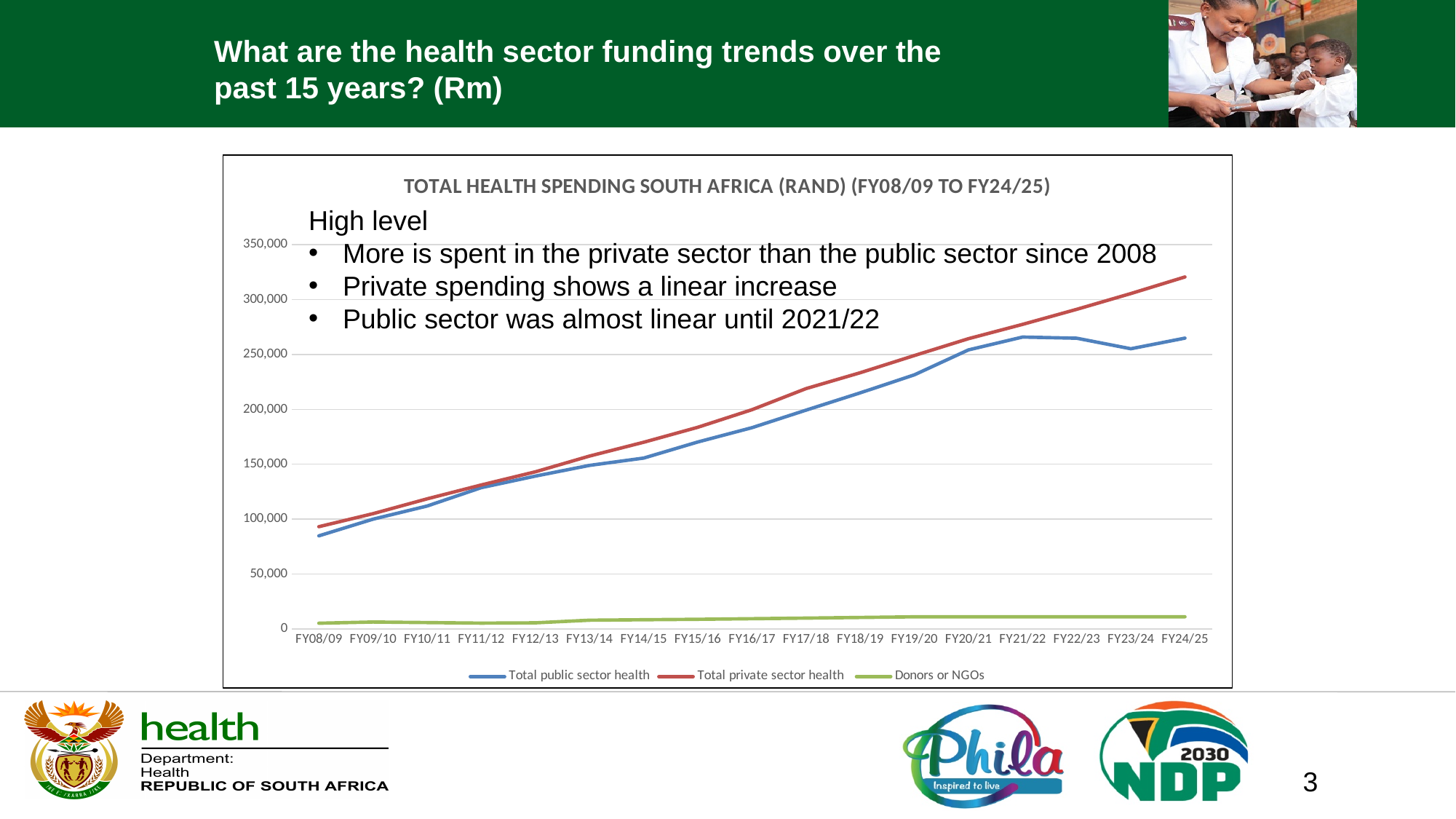
Is the value for Donors or NGOs in FY24/25 greater or less than 50,000? less What kind of chart is shown on the slide? Line chart How many series does the chart legend list? 3 Is the value for Total public sector health in FY08/09 greater or less than 100,000? less In FY24/25, which is larger: Total public sector health or Total private sector health? Total private sector health Is the value for Total private sector health in FY24/25 greater or less than 300,000? greater How many fiscal years are plotted along the x axis? 17 What is the title of the chart? TOTAL HEALTH SPENDING SOUTH AFRICA (RAND) (FY08/09 TO FY24/25) Does Total private sector health rise or fall from FY08/09 to FY24/25? Rise Which series has the highest value in FY24/25? Total private sector health Which series is drawn with the red line? Total private sector health Which series has the lowest value across all years? Donors or NGOs